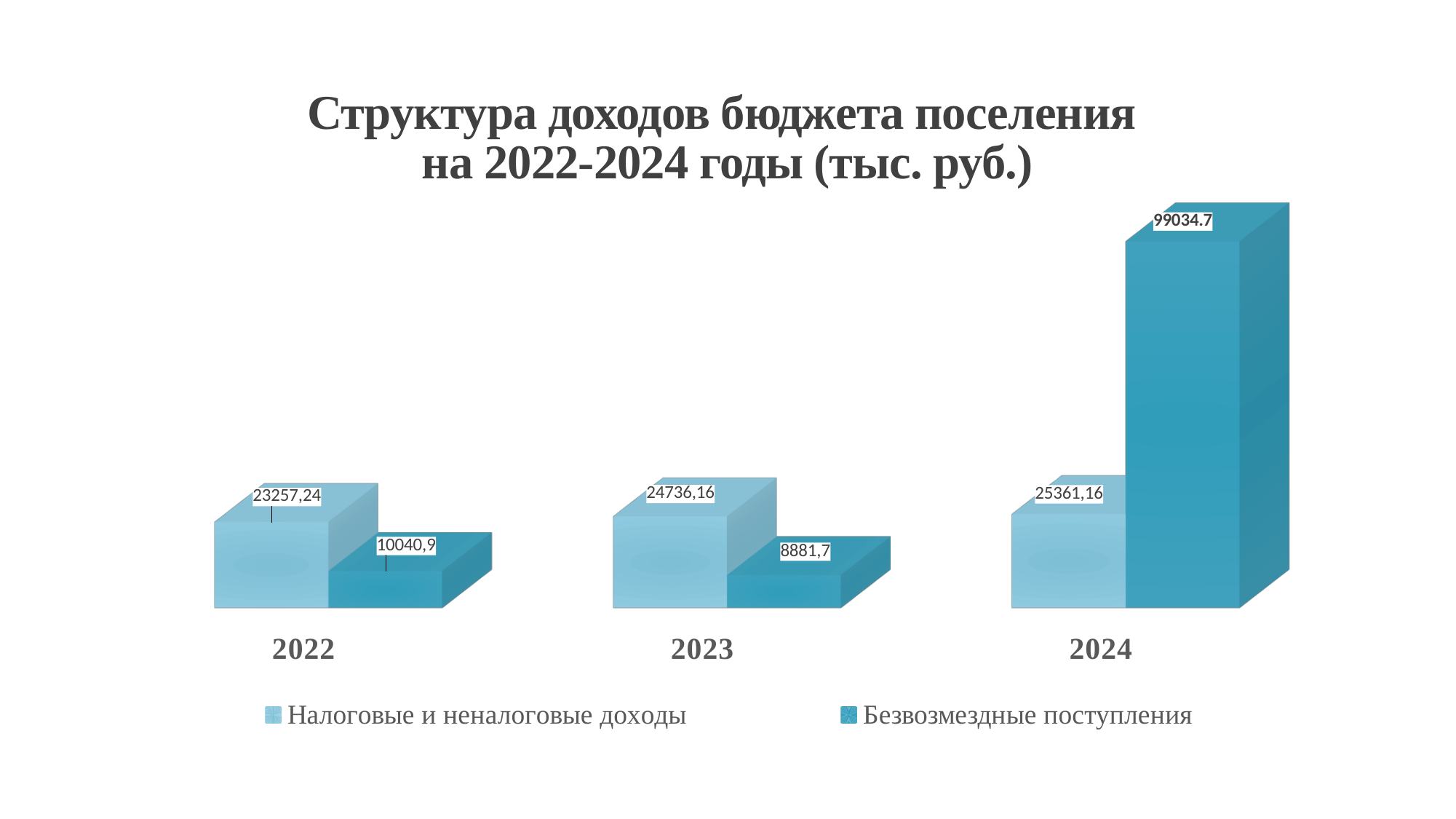
Which is larger in 2024: Налоговые и неналоговые доходы or Безвозмездные поступления? Безвозмездные поступления What is the difference between Налоговые и неналоговые доходы and Безвозмездные поступления in 2022? 13216,34 In which year is Безвозмездные поступления lowest? 2023 What kind of chart is shown on the slide? Bar chart How many series does the legend list? 2 In which year is Безвозмездные поступления highest? 2024 How many years are shown on the x axis? 3 What is the value of Безвозмездные поступления for 2023? 8881,7 Do the values for Налоговые и неналоговые доходы rise or fall from 2022 to 2024? Rise What is the value of Безвозмездные поступления for 2024? 99034.7 What is the value of Налоговые и неналоговые доходы for 2024? 25361,16 What is the value of Налоговые и неналоговые доходы for 2022? 23257,24